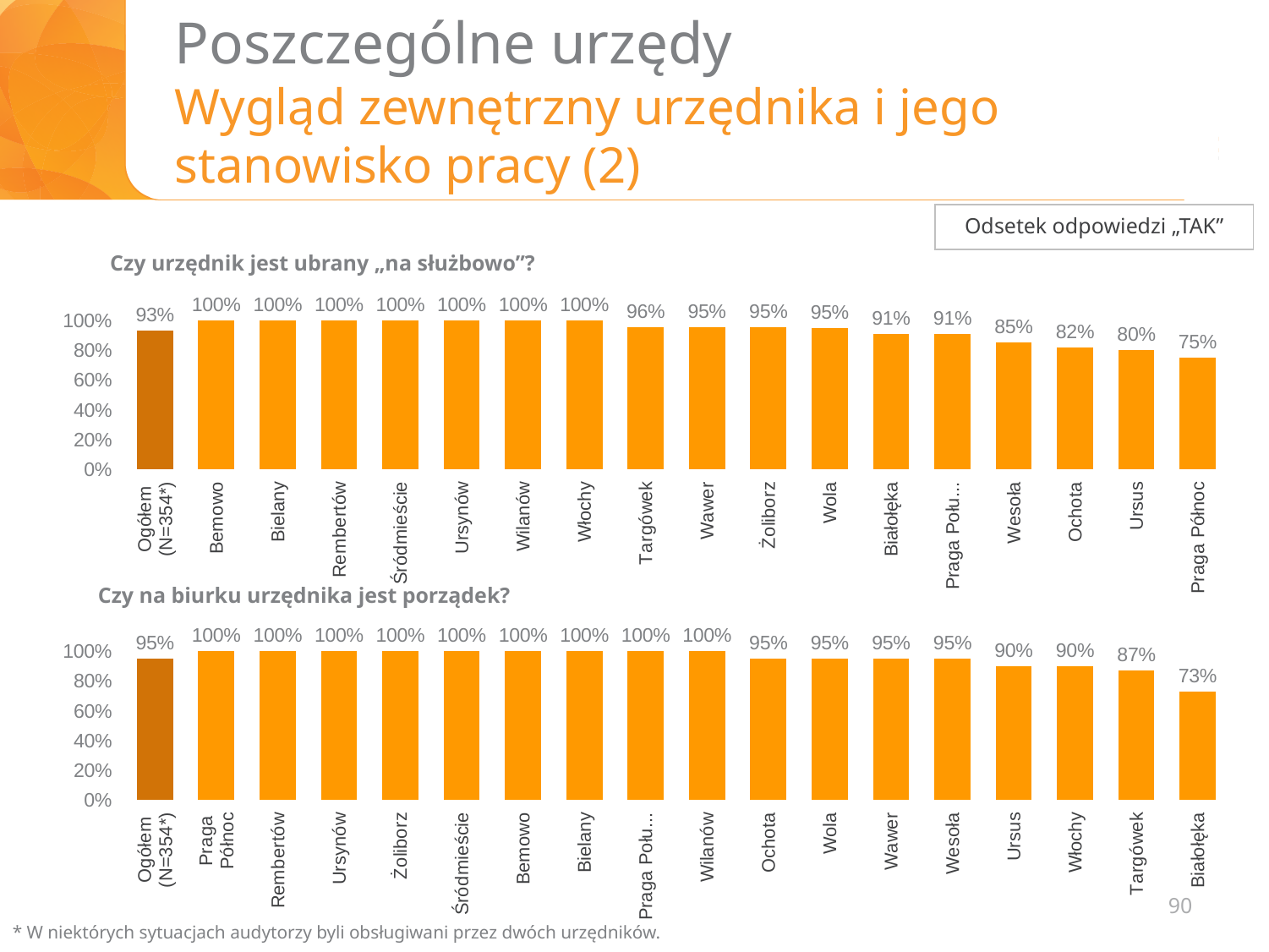
In the chart "Czy urzędnik jest ubrany „na służbowo”?", what is the value for Ochota? 82% In the chart "Czy na biurku urzędnika jest porządek?", what is the value for Ogółem (N=354*)? 95% In the chart "Czy urzędnik jest ubrany „na służbowo”?", which category has the lowest value? Praga Północ In the chart "Czy urzędnik jest ubrany „na służbowo”?", how many categories are shown? 18 In the chart "Czy na biurku urzędnika jest porządek?", which is larger, the value for Ursus or the value for Białołęka? Ursus In the chart "Czy na biurku urzędnika jest porządek?", which category has the lowest value? Białołęka What kind of chart is the top chart on the slide? Bar chart In the chart "Czy urzędnik jest ubrany „na służbowo”?", what is the difference between Targówek and Ursus? 16% In the chart "Czy urzędnik jest ubrany „na służbowo”?", do the values rise or fall from left to right after the Ogółem bar? Fall In the chart "Czy na biurku urzędnika jest porządek?", what is the value for Targówek? 87% In the chart "Czy urzędnik jest ubrany „na służbowo”?", what is the value for Ogółem (N=354*)? 93% In the chart "Czy na biurku urzędnika jest porządek?", what is the difference between Wesoła and Białołęka? 22%